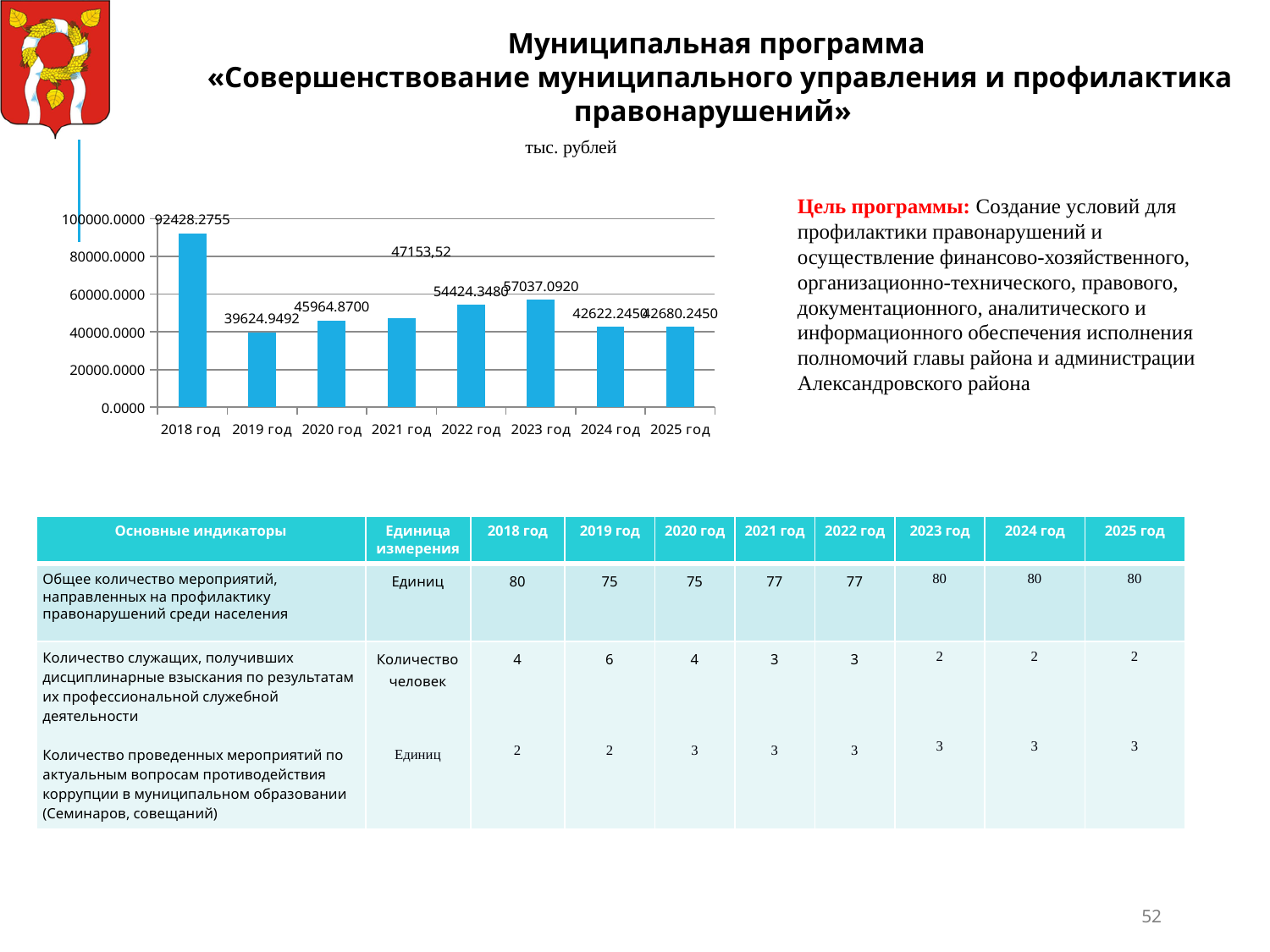
What is the value for 2018 год in the chart? 92428.2755 Which is larger in the chart, the value for 2022 год or 2023 год? 2023 год How many years (categories) are shown on the x axis of the chart? 8 What is the value for 2022 год in the chart? 54424.3480 What is the value for 2019 год in the chart? 39624.9492 Which year has the lowest value in the chart? 2019 год What is the difference between the values for 2023 год and 2022 год in the chart? 2612.7440 What kind of chart is shown on the slide? bar chart Do the values in the chart rise or fall from 2019 год to 2023 год? rise What is the value for 2023 год in the chart? 57037.0920 Is the value for 2024 год greater or less than 60000.0000? less Which year has the highest value in the chart? 2018 год